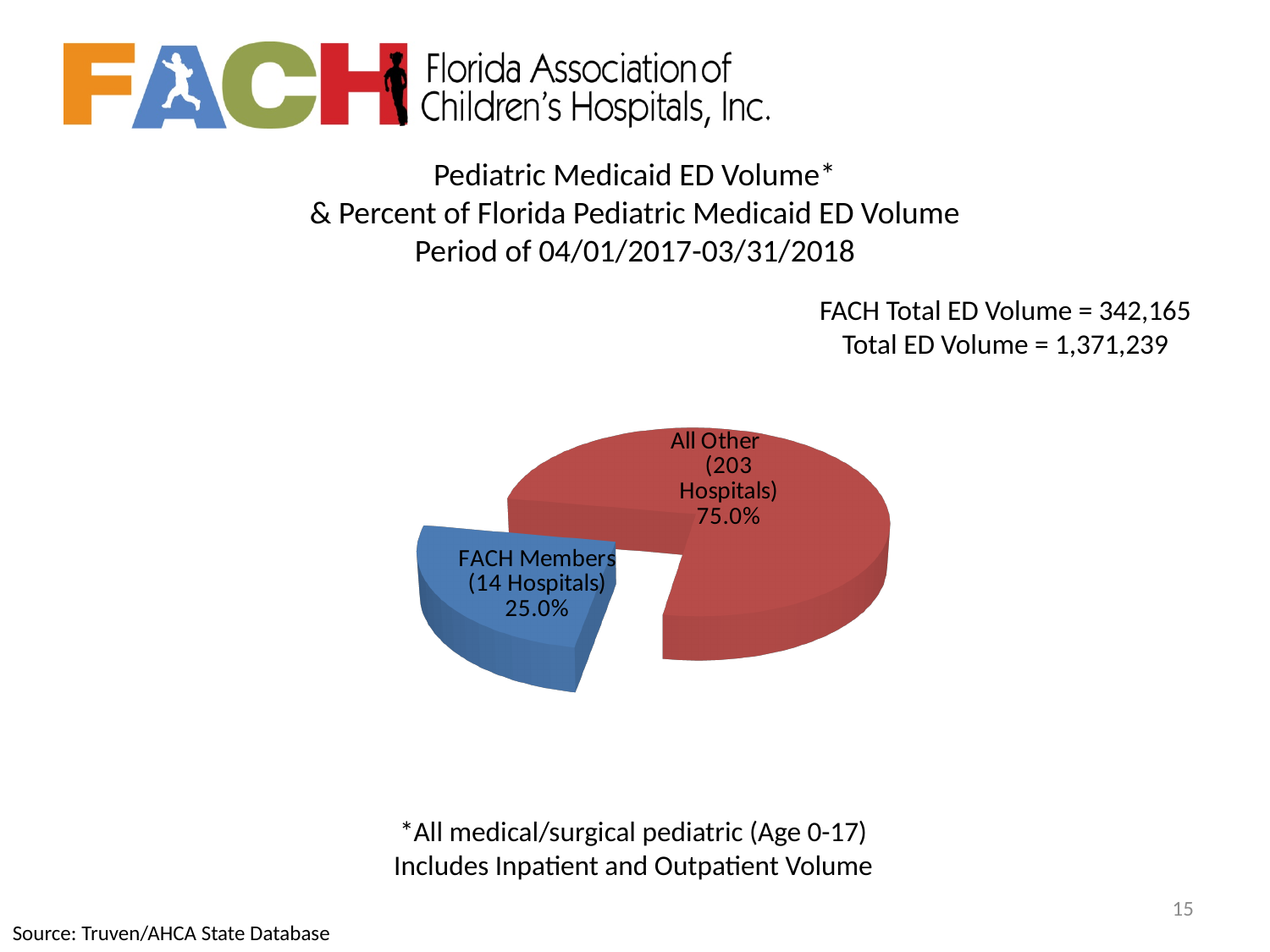
How many hospitals are included in the All Other slice? 203 Which slice of the pie is the smallest? FACH Members (14 Hospitals) What share of the pie does the FACH Members (14 Hospitals) slice represent? 25.0% How many hospitals are included in the FACH Members slice? 14 How many slices does the pie chart have? 2 What share of the pie does the All Other (203 Hospitals) slice represent? 75.0% Which slice of the pie is the largest? All Other (203 Hospitals) What kind of chart is shown on the slide? pie chart What period does the chart title say the data covers? 04/01/2017-03/31/2018 What is the difference in percentage points between the All Other slice and the FACH Members slice? 50.0% What colour is the FACH Members slice of the pie? blue Which is larger, the FACH Members slice or the All Other slice? All Other